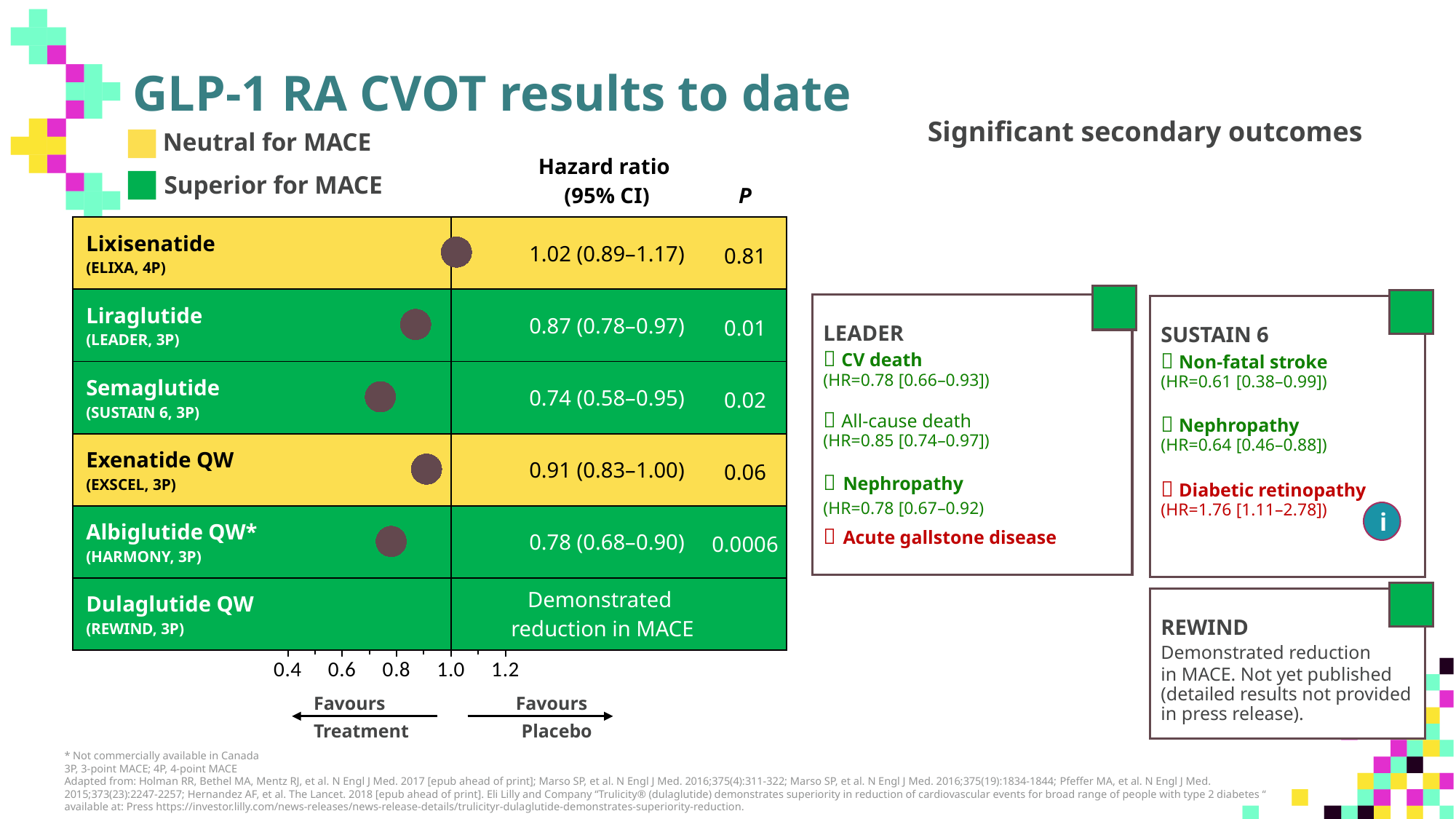
What kind of chart is used to display the hazard ratios on the slide? Forest plot What is the P value shown for Albiglutide QW (HARMONY, 3P)? 0.0006 Which trial drug has the lowest hazard ratio point estimate in the forest plot? Semaglutide What is the hazard ratio (95% CI) shown for Liraglutide (LEADER, 3P)? 0.87 (0.78–0.97) What is the difference between the hazard ratio point estimates for Lixisenatide and Semaglutide? 0.28 Which has the larger hazard ratio point estimate, Exenatide QW or Albiglutide QW? Exenatide QW Which trial drug has the highest hazard ratio point estimate in the forest plot? Lixisenatide Is the hazard ratio point for Lixisenatide greater or less than 1.0 on the axis? greater According to the legend, what does a yellow row indicate? Neutral for MACE What is the hazard ratio (95% CI) shown for Semaglutide (SUSTAIN 6, 3P)? 0.74 (0.58–0.95) How many drug/trial rows are listed in the forest plot? 6 How many hazard ratio points are plotted in the forest plot? 5